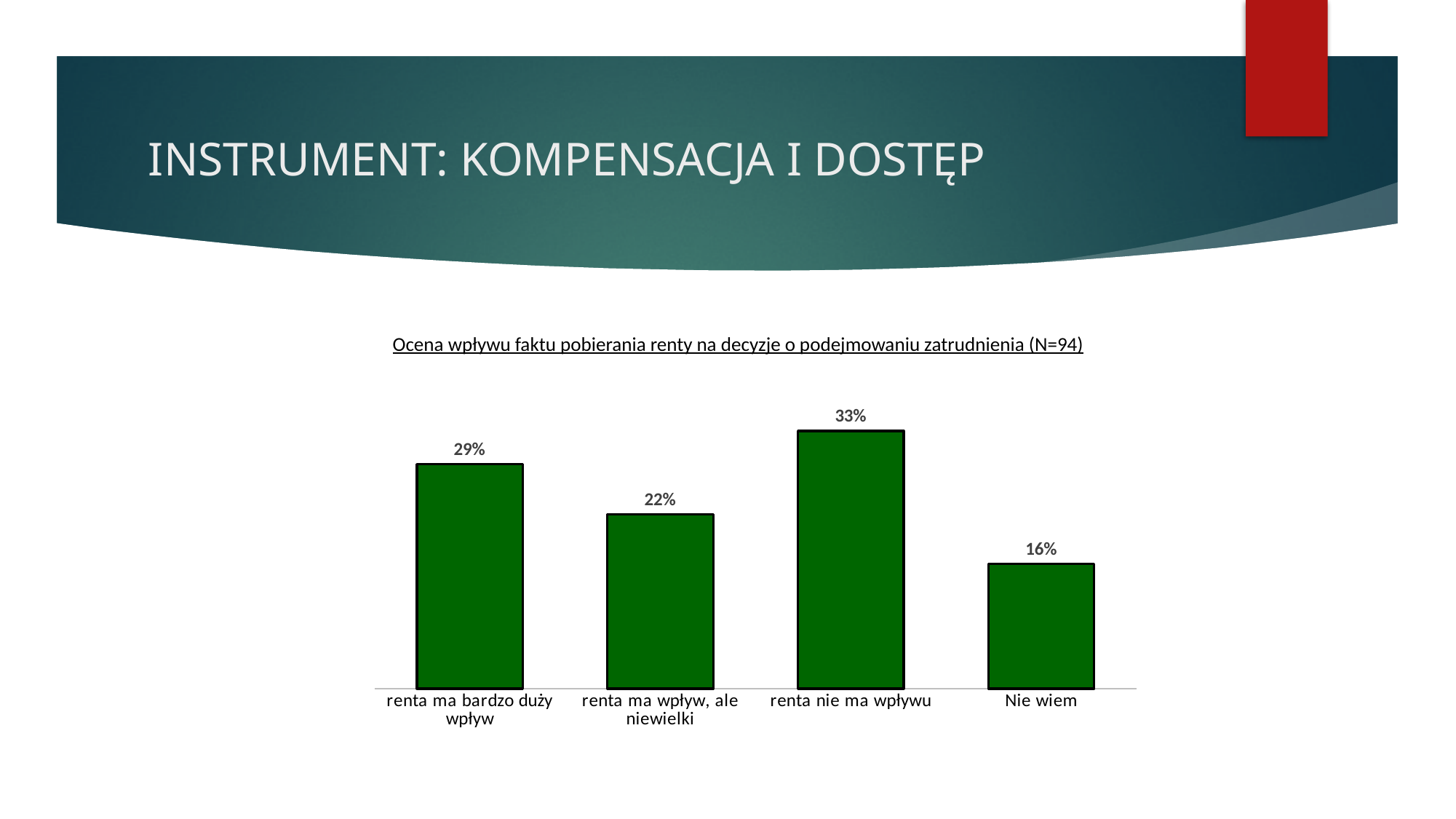
How many categories are shown in the chart? 4 What is the value for "renta ma bardzo duży wpływ"? 29% What is the value for "renta nie ma wpływu"? 33% What is the difference between the values for "renta ma bardzo duży wpływ" and "renta ma wpływ, ale niewielki"? 7% What kind of chart is shown on the slide? bar chart What is the value for "Nie wiem"? 16% Which category has the highest value? renta nie ma wpływu What is the value for "renta ma wpływ, ale niewielki"? 22% Which category has the lowest value? Nie wiem What is the difference between the values for "renta nie ma wpływu" and "Nie wiem"? 17% Which is larger: the value for "renta ma bardzo duży wpływ" or for "renta ma wpływ, ale niewielki"? renta ma bardzo duży wpływ What is the title of the chart? Ocena wpływu faktu pobierania renty na decyzje o podejmowaniu zatrudnienia (N=94)